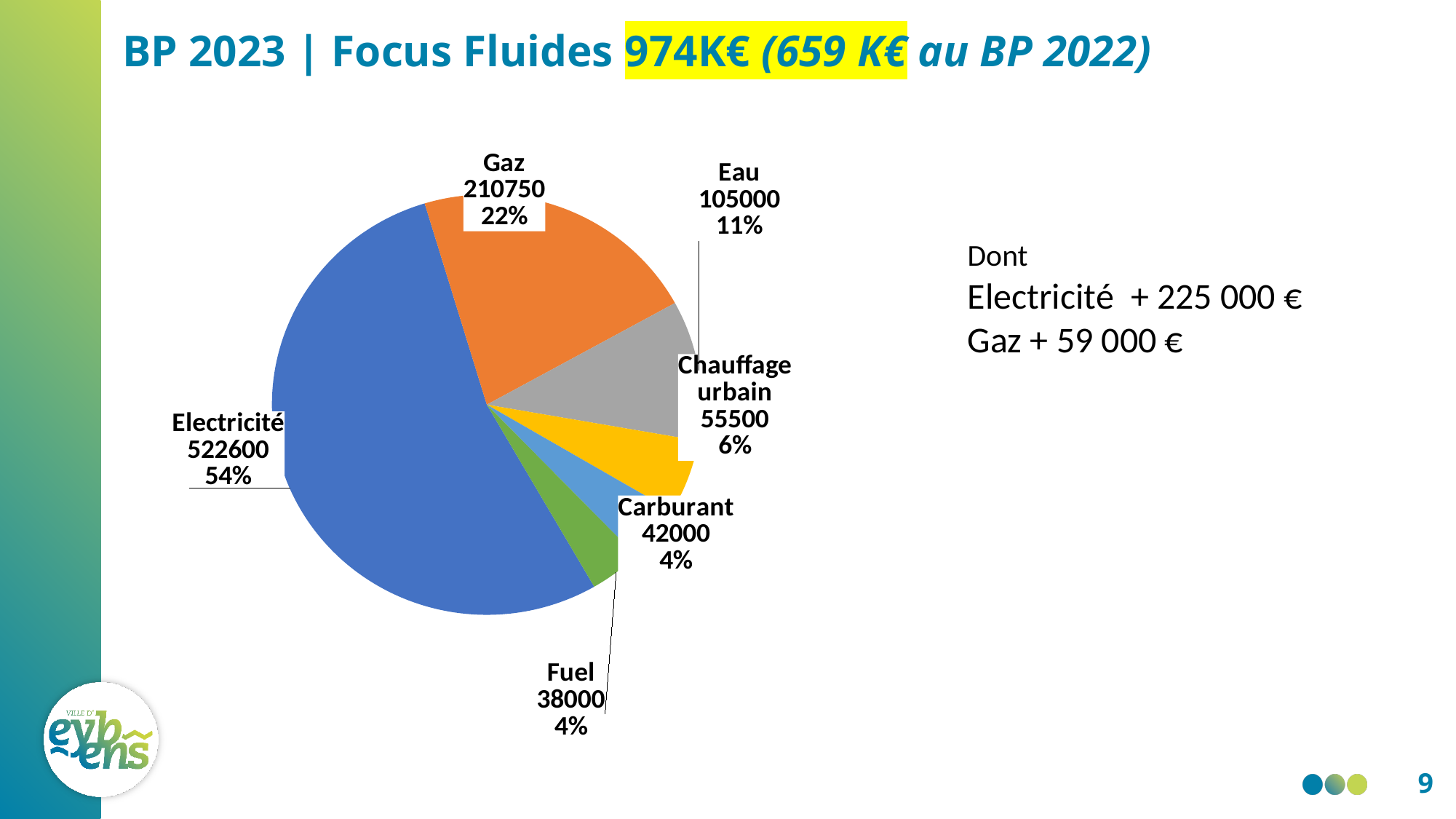
Which category has the smallest value in the pie chart? Fuel What colour is the Electricité slice of the pie chart? blue What is the value for Eau? 105000 What percentage share does Gaz have in the pie chart? 22% How many slices does the pie chart have? 6 What percentage share does Chauffage urbain have in the pie chart? 6% What is the difference between the values for Gaz and Eau? 105750 Which category has the largest slice of the pie? Electricité What is the value for Chauffage urbain? 55500 What type of chart is shown on the slide? pie chart What is the value for Electricité? 522600 Which is larger, the value for Carburant or the value for Fuel? Carburant